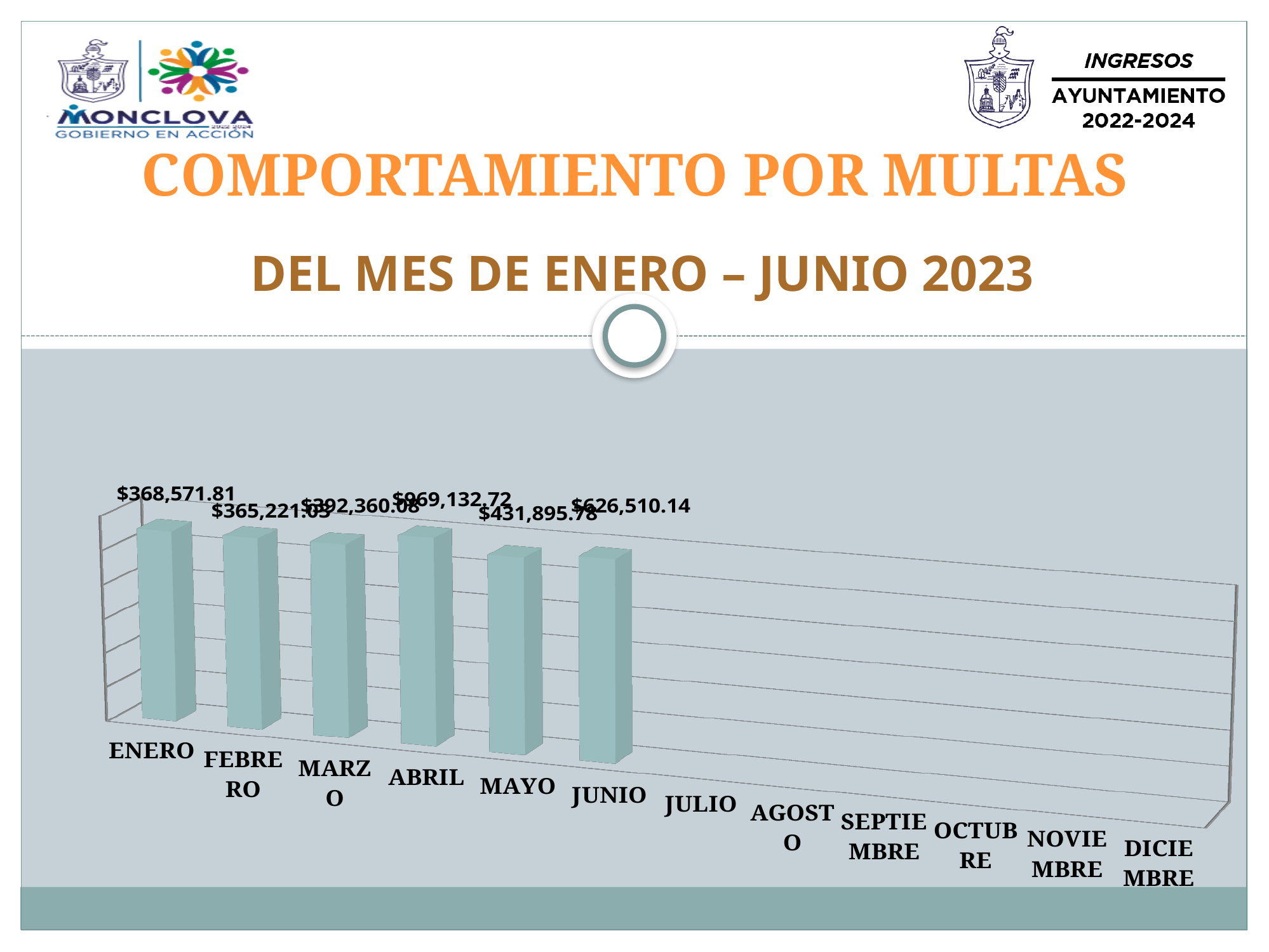
How many month categories are labelled on the x axis? 12 What is the difference between the values for JUNIO and ENERO? $257,938.33 What kind of chart is shown on the slide? Bar chart What is the difference between the values for JUNIO and MAYO? $194,614.36 Which is larger, the value for MAYO or the value for ENERO? MAYO What is the value shown for ENERO? $368,571.81 Which is larger, the value for ENERO or the value for JUNIO? JUNIO What is the title of the slide above the chart? COMPORTAMIENTO POR MULTAS DEL MES DE ENERO – JUNIO 2023 Which is the first month on the x axis with no bar plotted? JULIO How many months have a bar plotted on the chart? 6 What is the value shown for JUNIO? $626,510.14 What is the value shown for MAYO? $431,895.78